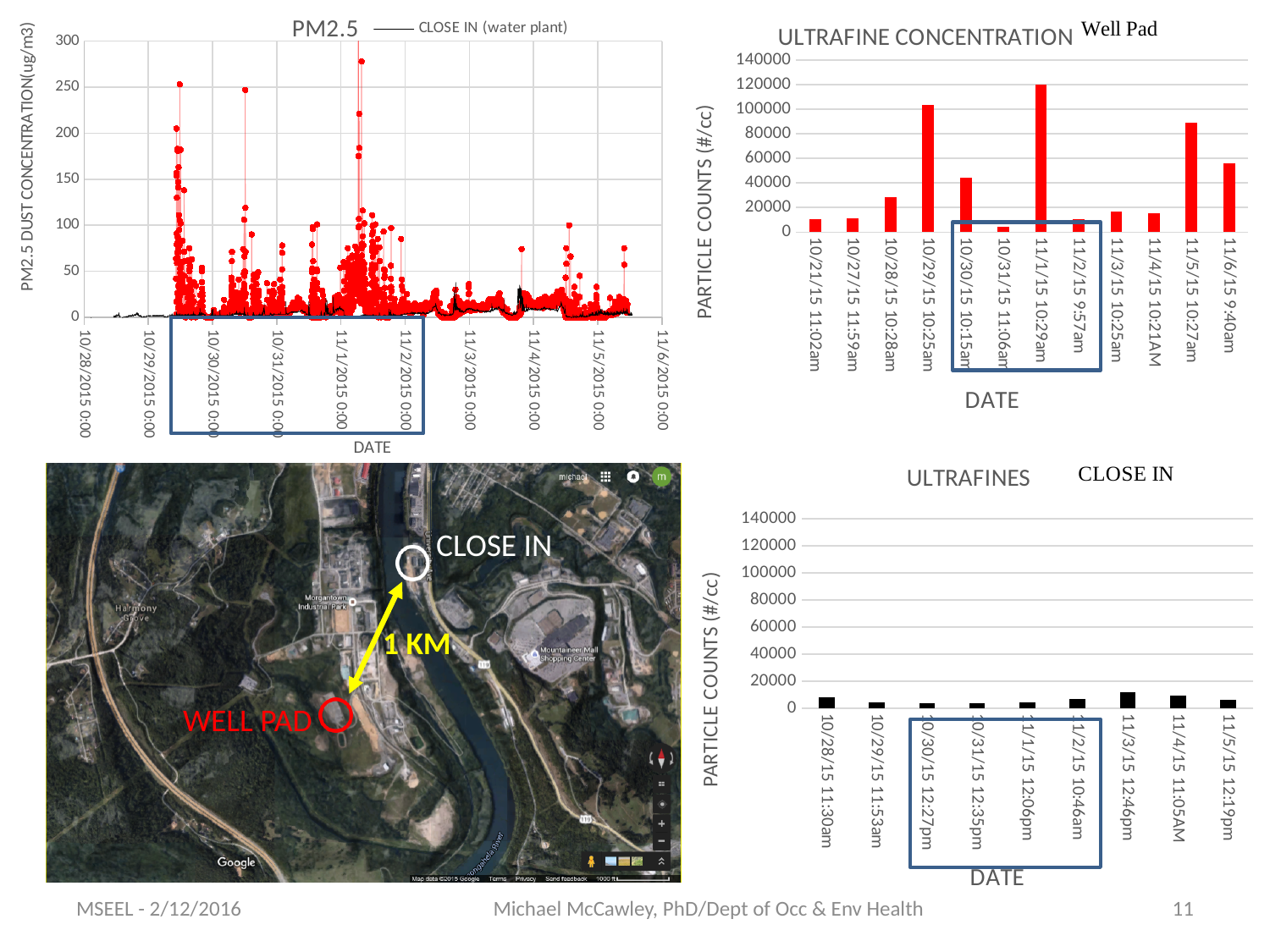
How many dates are plotted in the ULTRAFINE CONCENTRATION (Well Pad) chart? 12 How many dates are plotted in the ULTRAFINES (CLOSE IN) chart? 9 In the ULTRAFINE CONCENTRATION (Well Pad) chart, is the value for 11/5/15 10:27am greater or less than 80000? greater In the ULTRAFINE CONCENTRATION (Well Pad) chart, which date has the lowest particle count? 10/31/15 11:06am In the ULTRAFINE CONCENTRATION (Well Pad) chart, which is larger: the value for 10/29/15 10:25am or 11/5/15 10:27am? 10/29/15 10:25am In the ULTRAFINES (CLOSE IN) chart, is the value for 11/3/15 12:46pm greater or less than 20000? less In the ULTRAFINE CONCENTRATION (Well Pad) chart, which date has the highest particle count? 11/1/15 10:29am In the ULTRAFINES (CLOSE IN) chart, which date has the highest particle count? 11/3/15 12:46pm What is the legend entry shown on the PM2.5 chart? CLOSE IN (water plant) In the ULTRAFINE CONCENTRATION (Well Pad) chart, is the value for 10/29/15 10:25am greater or less than 80000? greater What is the y-axis label of the ULTRAFINES (CLOSE IN) chart? PARTICLE COUNTS (#/cc) What kind of chart is the ULTRAFINE CONCENTRATION (Well Pad) chart? bar chart